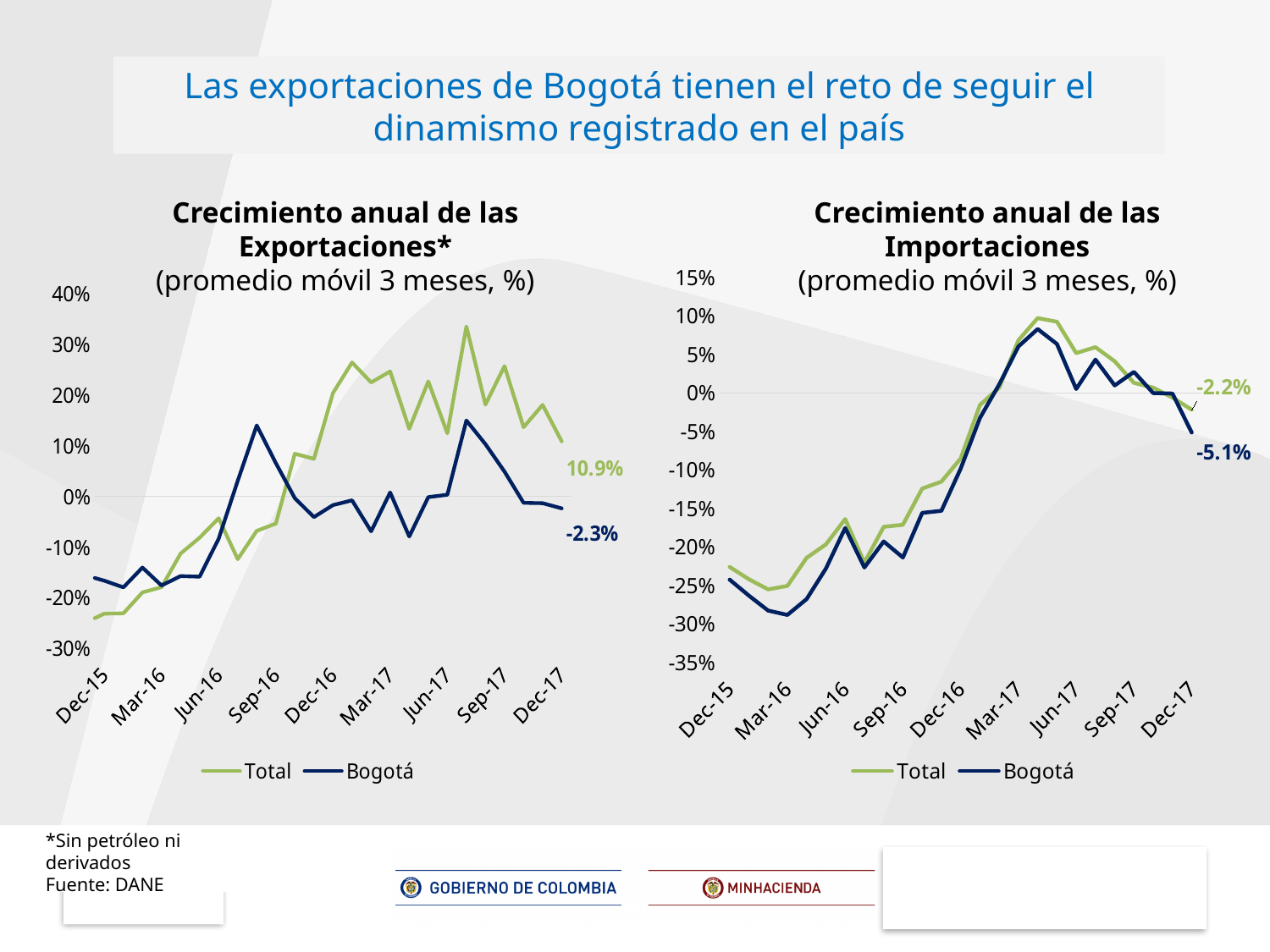
In the 'Crecimiento anual de las Exportaciones*' chart, what is the labelled value for Bogotá at the end of the series (Dec-17)? -2.3% In the 'Crecimiento anual de las Exportaciones*' chart, what is the difference in percentage points between the final labelled Total value and the final labelled Bogotá value? 13.2 percentage points In the 'Crecimiento anual de las Importaciones' chart, what is the labelled value for Bogotá at the end of the series (Dec-17)? -5.1% In the 'Crecimiento anual de las Exportaciones*' chart, is the peak value of the Total series around Sep-17 greater or less than 30%? greater In the 'Crecimiento anual de las Importaciones' chart, which series has the higher final labelled value, Total or Bogotá? Total In the 'Crecimiento anual de las Importaciones' chart, what is the difference in percentage points between the final labelled Total value and the final labelled Bogotá value? 2.9 percentage points In the 'Crecimiento anual de las Importaciones' chart, what is the labelled value for Total at the end of the series (Dec-17)? -2.2% What type of chart is the 'Crecimiento anual de las Importaciones' chart? Line chart How many series does the legend of the 'Crecimiento anual de las Exportaciones*' chart list? 2 In the 'Crecimiento anual de las Importaciones' chart, is the value for Bogotá at Mar-16 greater or less than -25%? less In the 'Crecimiento anual de las Importaciones' chart, does the Total series rise or fall between Mar-16 and Mar-17? Rise In the 'Crecimiento anual de las Exportaciones*' chart, what is the labelled value for Total at the end of the series (Dec-17)? 10.9%